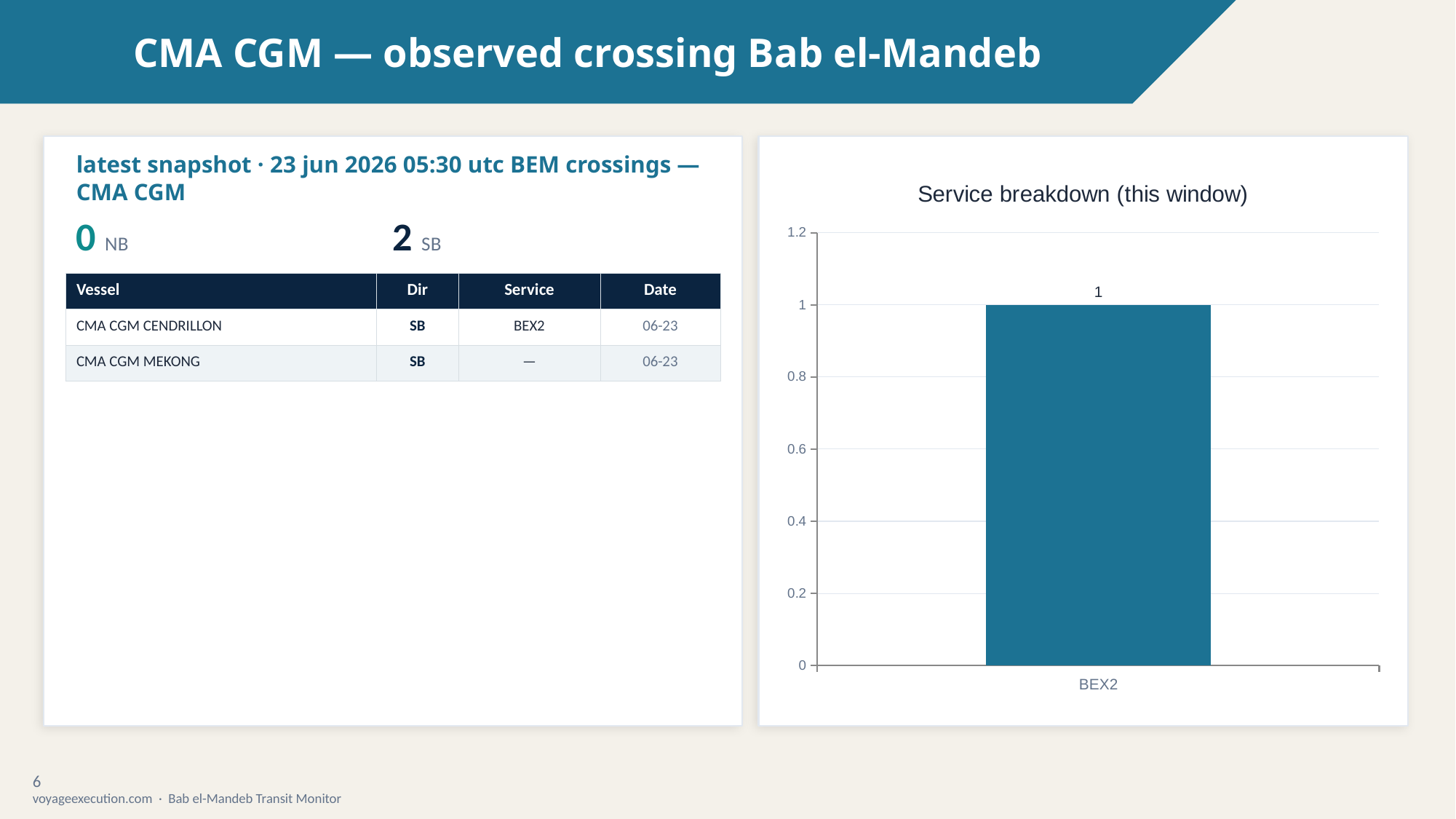
Is the value for BEX2 in the Service breakdown chart greater or less than 1.2? less How many categories are plotted in the Service breakdown chart? 1 What is the value for BEX2 in the Service breakdown chart? 1 Which category is shown on the x axis of the Service breakdown chart? BEX2 What kind of chart is the Service breakdown chart? bar chart What is the title of the chart on the slide? Service breakdown (this window) What is the highest value shown on the y axis of the Service breakdown chart? 1.2 Is the value for BEX2 in the Service breakdown chart greater or less than 0.8? greater